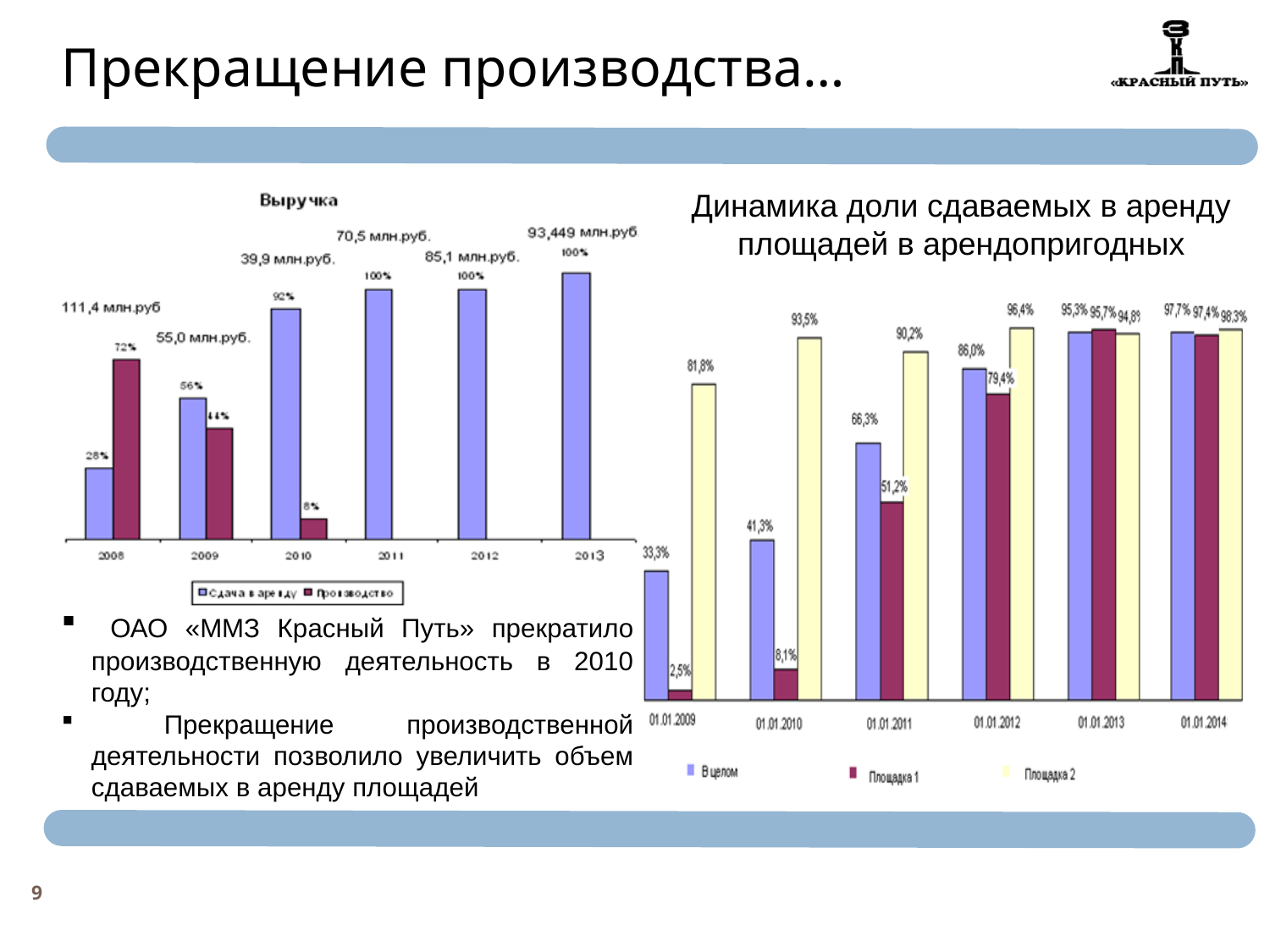
In the 'Динамика доли сдаваемых в аренду площадей в арендопригодных' chart, what is the value for 'Площадка 1' on 01.01.2011? 51,2% In the 'Выручка' chart, what percentage is shown for 'Сдача в аренду' in 2009? 56% In the 'Выручка' chart, what percentage is shown for 'Производство' in 2010? 8% In the 'Динамика доли сдаваемых в аренду площадей в арендопригодных' chart, which is larger on 01.01.2009: 'В целом' or 'Площадка 2'? Площадка 2 In the 'Выручка' chart, what is the revenue label shown for 2008? 111,4 млн.руб In the 'Динамика доли сдаваемых в аренду площадей в арендопригодных' chart, which date has the lowest value for 'Площадка 1'? 01.01.2009 In the 'Выручка' chart, how many years are shown on the x axis? 6 In the 'Выручка' chart, does the share of 'Сдача в аренду' rise or fall from 2008 to 2011? rise In the 'Выручка' chart, how many series does the legend list? 2 In the 'Динамика доли сдаваемых в аренду площадей в арендопригодных' chart, what is the value for 'В целом' on 01.01.2012? 86,0% What type of chart is the 'Динамика доли сдаваемых в аренду площадей в арендопригодных' chart? bar chart In the 'Динамика доли сдаваемых в аренду площадей в арендопригодных' chart, what is the difference between 'Площадка 2' and 'Площадка 1' on 01.01.2010? 85,4%